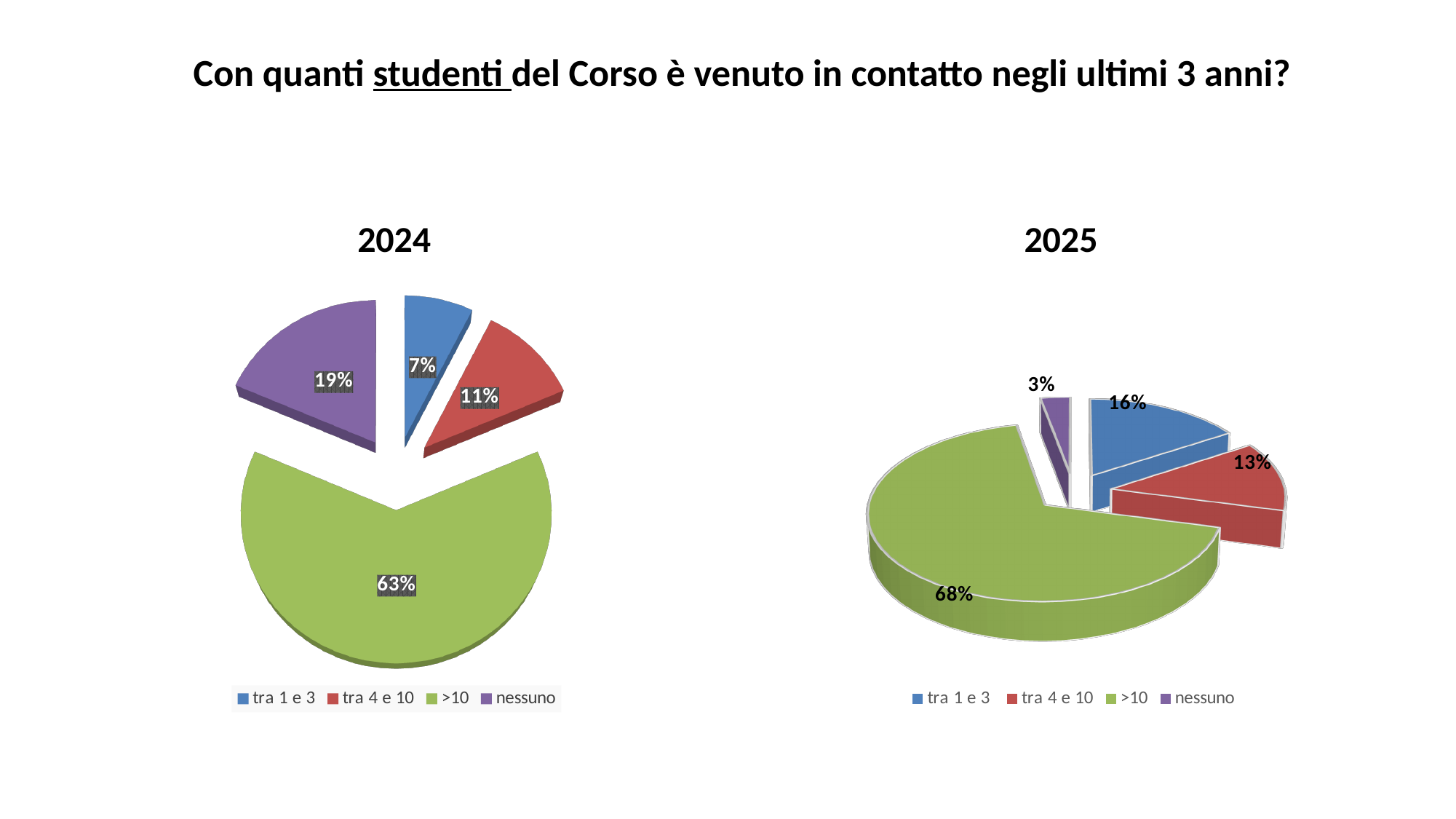
In the 2024 chart, what share of respondents answered '>10'? 63% In the 2025 chart, what is the difference in percentage points between '>10' and 'tra 1 e 3'? 52 How many categories does the 2025 chart show? 4 In the 2025 chart, what colour is the '>10' slice? Green In the 2024 chart, which is larger: 'tra 4 e 10' or 'nessuno'? nessuno In the 2025 chart, what share of respondents answered 'tra 1 e 3'? 16% In the 2025 chart, what share of respondents answered 'nessuno'? 3% In the 2024 chart, what share of respondents answered 'nessuno'? 19% In the 2024 chart, which category has the smallest slice? tra 1 e 3 In the 2024 chart, which category has the largest slice? >10 What kind of chart is the 2024 chart? Pie chart In the 2025 chart, which category has the smallest slice? nessuno